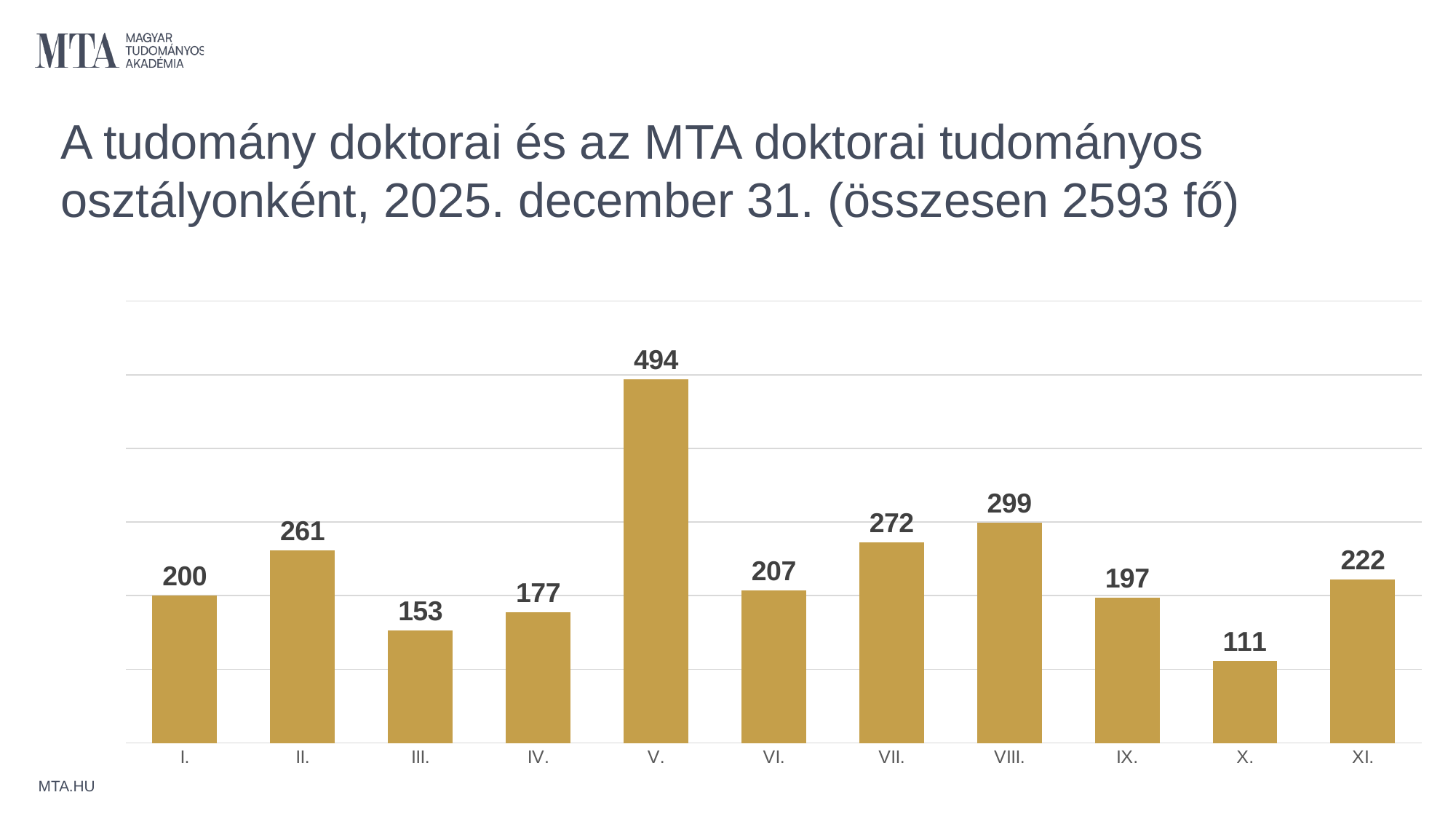
What is the difference between the values for V. and VIII.? 195 How many categories are shown on the x axis? 11 What kind of chart is shown on the slide? bar chart What is the value for category X.? 111 Which is larger, the value for VII. or the value for XI.? VII. Which category has the lowest value? X. What is the difference between the values for II. and III.? 108 What total number of people is stated in the slide title? 2593 fő Which is larger, the value for I. or the value for IX.? I. What is the value for category V.? 494 Which category has the highest value? V. What is the value for category VIII.? 299